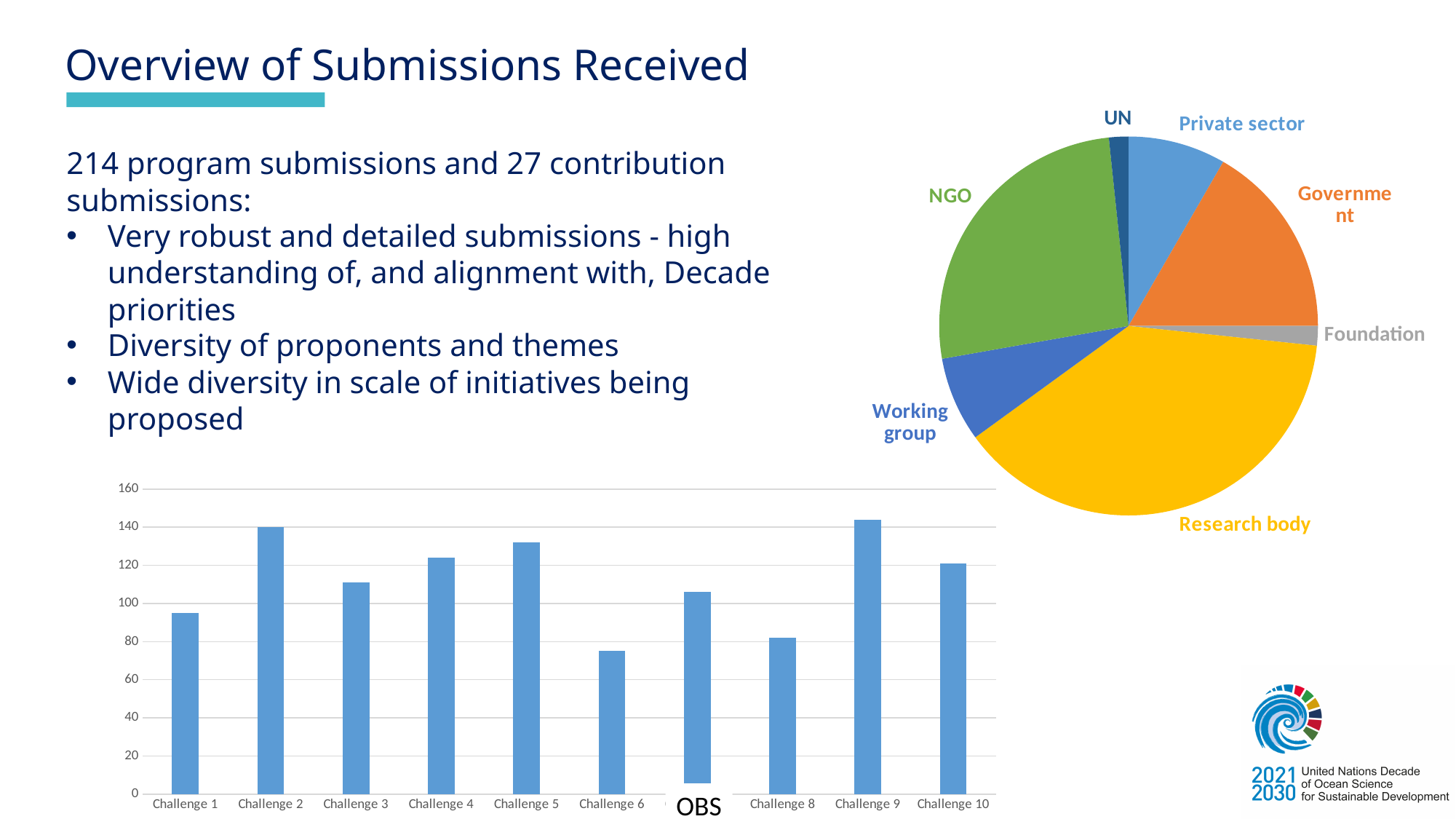
In the bar chart at the bottom left, which bar is taller, Challenge 3 or Challenge 4? Challenge 4 What kind of chart is the chart in the top right of the slide? pie chart In the pie chart at the top right, how many slices are there? 7 In the pie chart at the top right, which category has the largest slice? Research body In the bar chart at the bottom left, is the value for Challenge 1 greater or less than 100? less In the pie chart at the top right, which slice is larger, NGO or Government? NGO What kind of chart is the chart in the bottom left of the slide? bar chart In the bar chart at the bottom left, is the value for Challenge 2 greater or less than 120? greater In the bar chart at the bottom left, how many challenge categories are shown on the x axis? 10 In the bar chart at the bottom left, which challenge has the lowest bar? Challenge 6 In the bar chart at the bottom left, what is the highest value shown on the vertical axis? 160 In the bar chart at the bottom left, is the value for Challenge 6 greater or less than 80? less